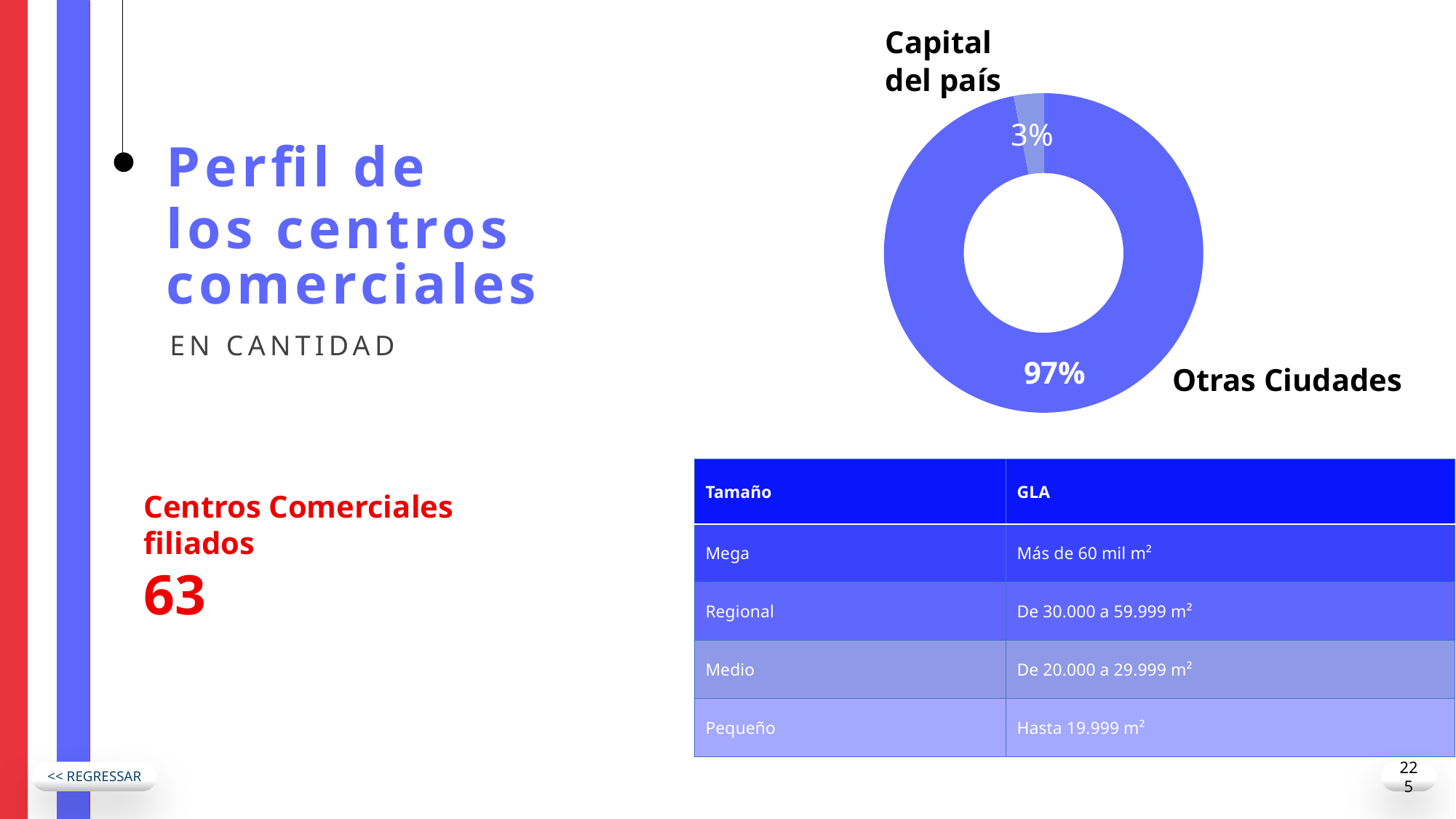
Is the share for Otras Ciudades greater or less than 50%? greater What share of the donut chart corresponds to Otras Ciudades? 97% What type of chart is shown on the slide? Donut (pie) chart How many categories are shown in the donut chart? 2 What is the total of the two shares shown in the donut chart? 100% What is the subtitle shown under the slide title 'Perfil de los centros comerciales'? EN CANTIDAD What is the difference in percentage points between Otras Ciudades and Capital del país in the donut chart? 94 Which is larger in the donut chart: Capital del país or Otras Ciudades? Otras Ciudades What share of the donut chart corresponds to Capital del país? 3% Which category has the largest share in the donut chart? Otras Ciudades How many Centros Comerciales afiliados does the slide report? 63 Which category has the smallest share in the donut chart? Capital del país